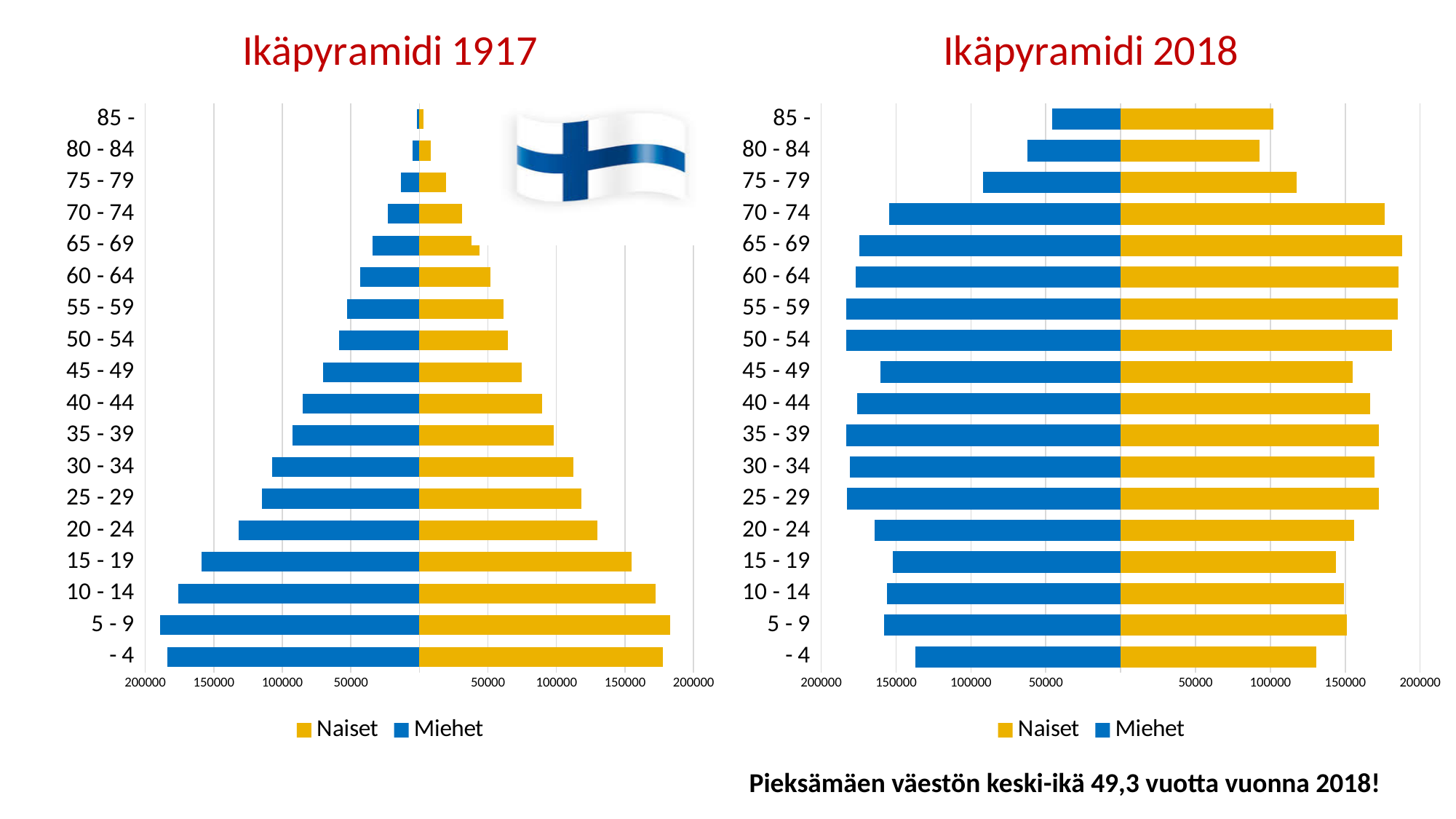
In 'Ikäpyramidi 1917', do the Naiset bars get longer or shorter as the age groups get older? shorter How many series does the legend of 'Ikäpyramidi 1917' list? 2 In 'Ikäpyramidi 1917', is the Naiset value for 45 - 49 greater or less than 50000? greater What kind of chart is 'Ikäpyramidi 1917'? bar chart In 'Ikäpyramidi 2018', which age group has the smallest Naiset value? 80 - 84 In 'Ikäpyramidi 2018', which age group has the smallest Miehet value? 85 - In 'Ikäpyramidi 1917', is the Miehet value for 5 - 9 greater or less than 150000? greater In 'Ikäpyramidi 2018', which is larger for the 85 - age group, Naiset or Miehet? Naiset In 'Ikäpyramidi 2018', is the Naiset value for 70 - 74 greater or less than 150000? greater What are the two legend entries on the 'Ikäpyramidi 2018' chart? Naiset, Miehet In 'Ikäpyramidi 1917', which age group has the smallest Naiset value? 85 - How many age groups are shown on the 'Ikäpyramidi 2018' chart? 18